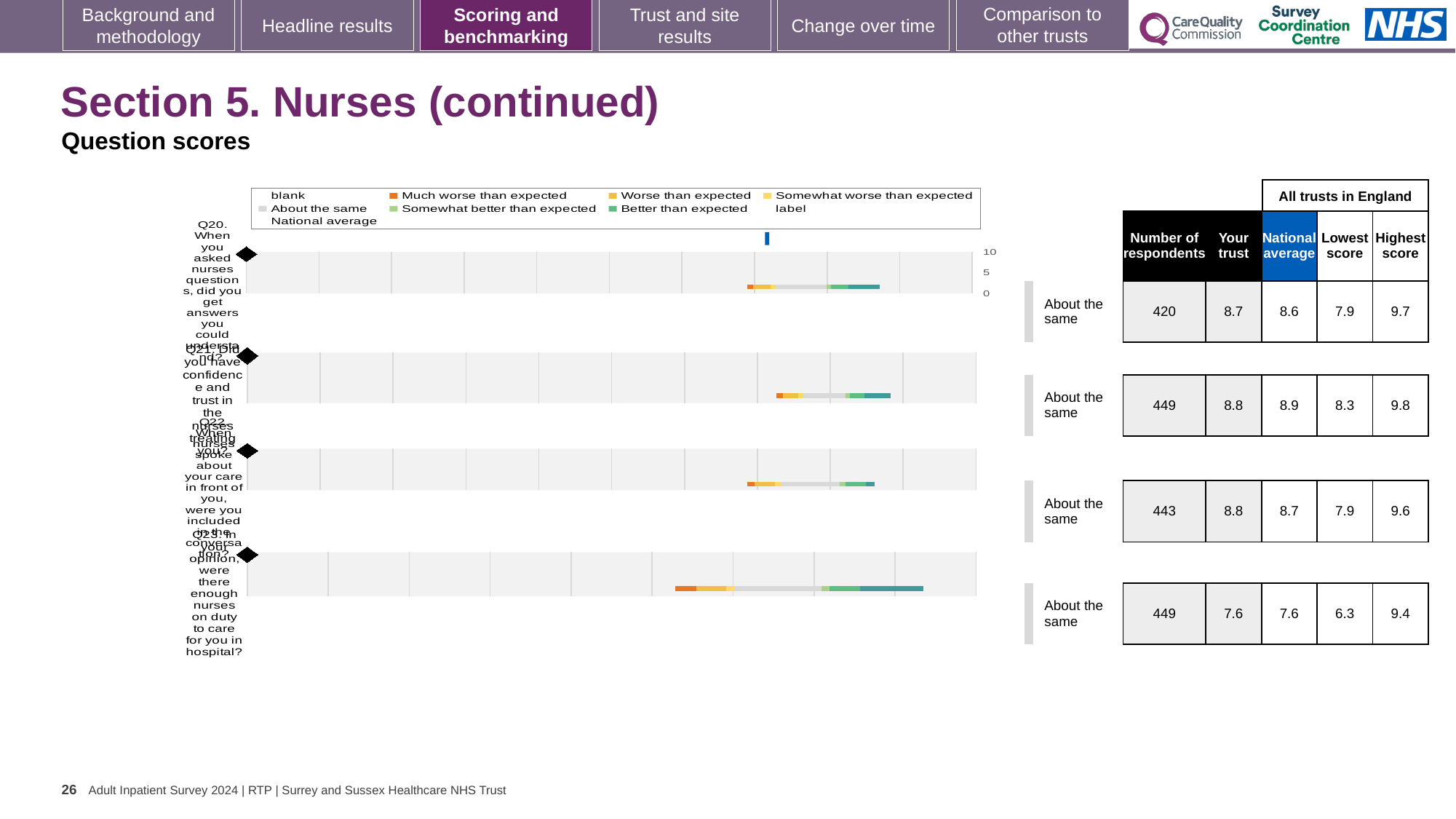
In the table beside the chart, which question has the highest 'Highest score' value? Q21 What benchmark category is shown for Q23 next to the chart? About the same For Q21, which is larger: the 'Your trust' score or the national average? national average In the table beside the chart, what is the number of respondents for Q22? 443 In the chart legend, which colour represents 'Much worse than expected'? orange In the table beside the chart, what is the 'Your trust' score for Q20? 8.7 In the table beside the chart, what is the difference between the highest score and the lowest score for Q20? 1.8 What kind of chart is shown on the slide? bar chart In the table beside the chart, which question has the lowest 'Lowest score' value? Q23 What is the maximum value shown on the chart's score axis? 10 How many questions (categories) are plotted in the chart? 4 In the table beside the chart, what is the national average for Q23? 7.6